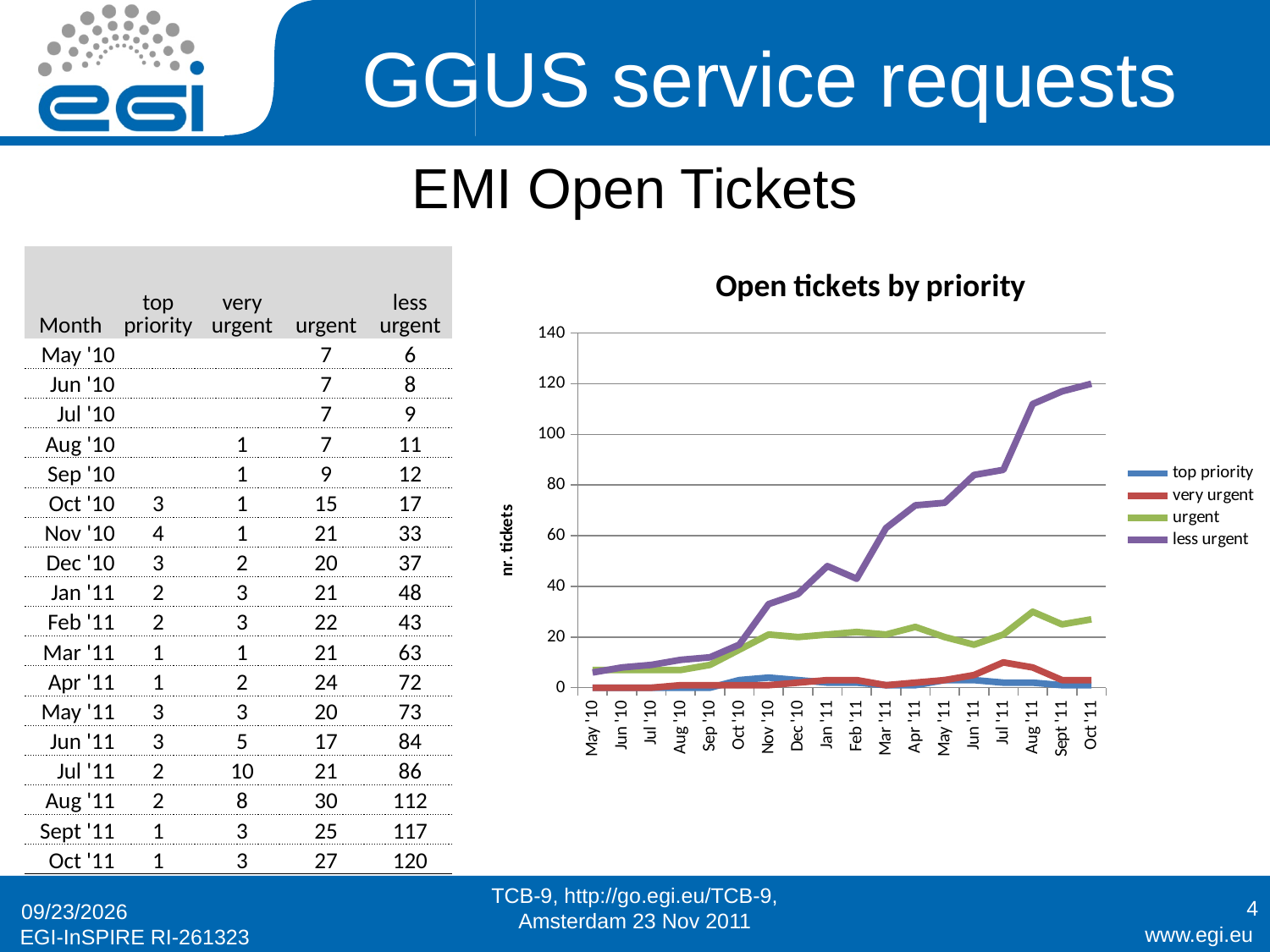
In which month is the 'less urgent' series at its lowest value? May '10 Is the value for 'less urgent' in Aug '11 greater or less than 100? greater Which series has the highest value in Oct '11 on the 'Open tickets by priority' chart? less urgent What is the difference between the 'less urgent' values for Oct '11 and Sept '11? 3 What is the number of 'less urgent' open tickets in Oct '11? 120 Is the value for 'urgent' in Mar '11 greater or less than 40? less How many months are plotted along the x axis of the 'Open tickets by priority' chart? 18 What is the number of 'urgent' open tickets in Aug '11? 30 What kind of chart is 'Open tickets by priority'? line chart In Jul '11, which is larger: the 'urgent' value or the 'very urgent' value? urgent Does the 'less urgent' series rise or fall from May '10 to Oct '11? rise How many series does the legend of the 'Open tickets by priority' chart list? 4